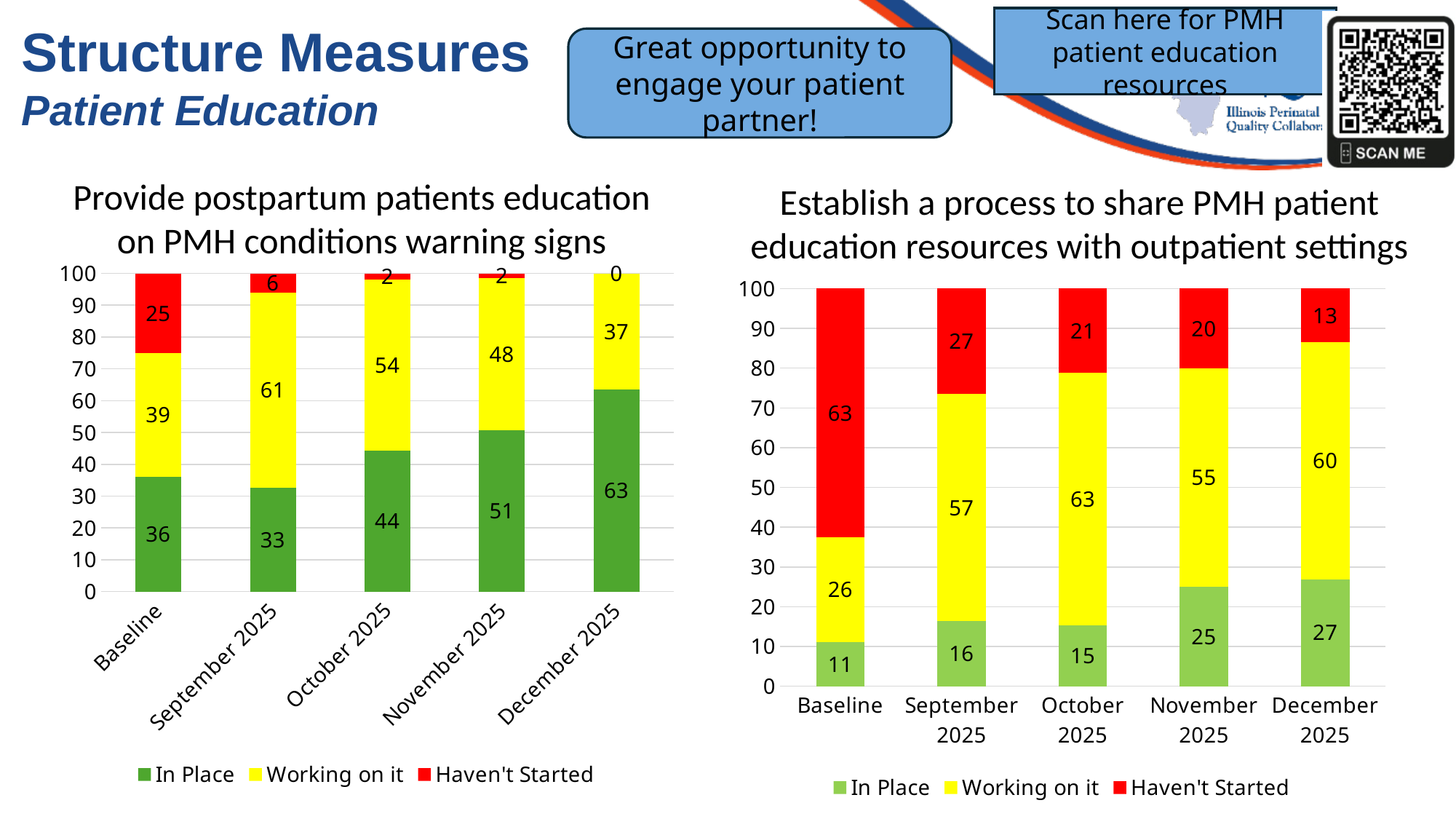
In the chart 'Provide postpartum patients education on PMH conditions warning signs', what is the 'Haven't Started' value at Baseline? 25 In the chart 'Provide postpartum patients education on PMH conditions warning signs', what is the 'In Place' value for December 2025? 63 In the chart 'Provide postpartum patients education on PMH conditions warning signs', what is the difference between the 'Working on it' values for September 2025 and December 2025? 24 In the chart 'Establish a process to share PMH patient education resources with outpatient settings', is the 'In Place' value larger for November 2025 or October 2025? November 2025 In the chart 'Provide postpartum patients education on PMH conditions warning signs', which category has the highest 'In Place' value? December 2025 In the chart 'Establish a process to share PMH patient education resources with outpatient settings', how does the 'Haven't Started' value change from Baseline to December 2025? It falls In the chart 'Establish a process to share PMH patient education resources with outpatient settings', what is the 'Haven't Started' value at Baseline? 63 What type of chart is 'Provide postpartum patients education on PMH conditions warning signs'? Stacked bar chart How many series does the legend list in the chart 'Establish a process to share PMH patient education resources with outpatient settings'? 3 In the chart 'Establish a process to share PMH patient education resources with outpatient settings', which category has the lowest 'Haven't Started' value? December 2025 In the chart 'Provide postpartum patients education on PMH conditions warning signs', which category has the lowest 'In Place' value? September 2025 In the chart 'Establish a process to share PMH patient education resources with outpatient settings', what is the 'Working on it' value for October 2025? 63